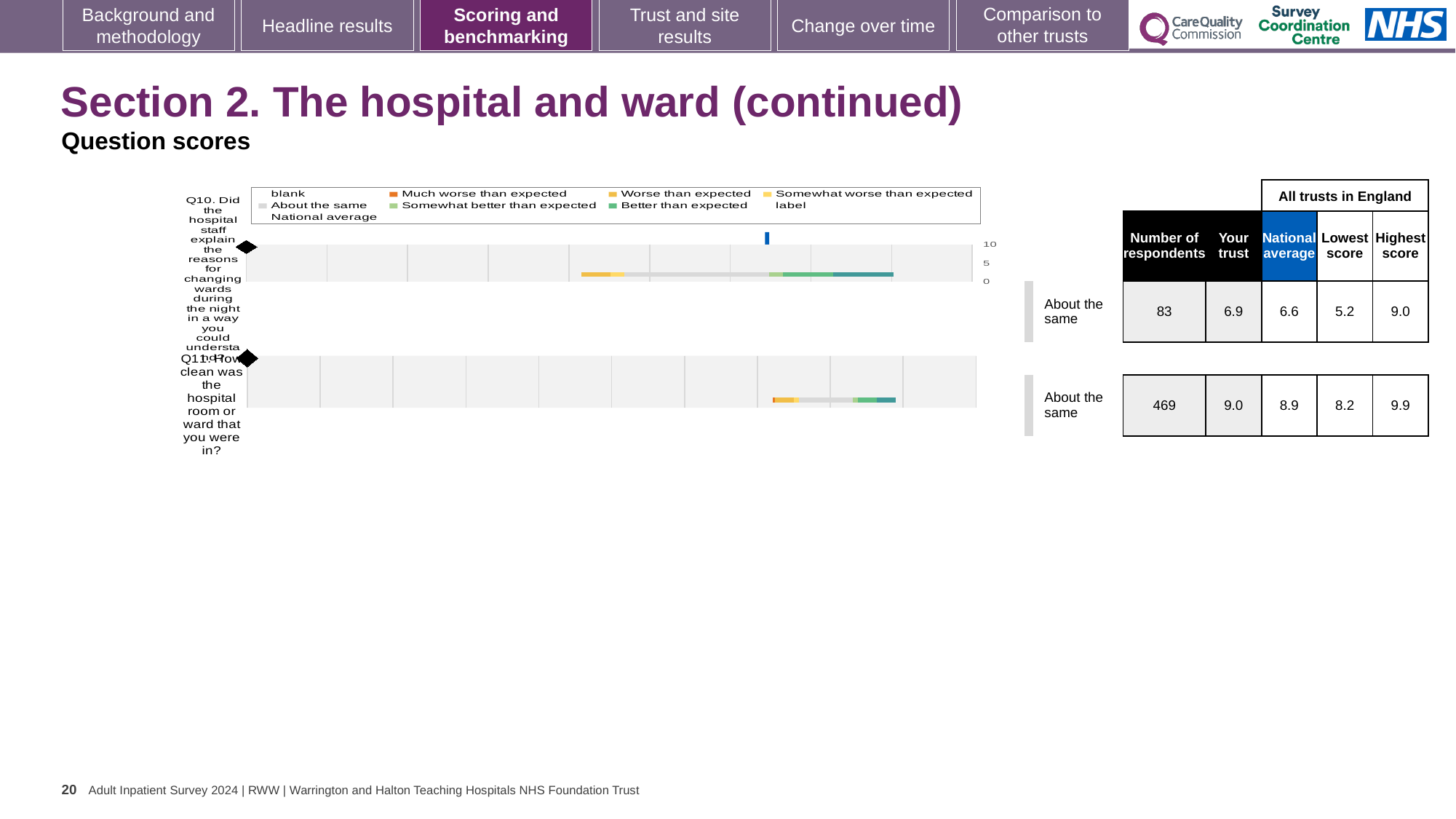
What is the highest score among all trusts in England for Q10? 9.0 What is the trust's score for Q10 (Did the hospital staff explain the reasons for changing wards during the night in a way you could understand?)? 6.9 What is the national average score for Q10? 6.6 What benchmarking category is shown for both Q10 and Q11? About the same Which question has the higher trust score, Q10 or Q11? Q11 How many respondents answered Q11? 469 What kind of chart is used to show the question scores on this slide? bar chart What is the difference between the trust's score and the national average for Q10? 0.3 How many survey questions are plotted in the chart? 2 What is the national average score for Q11? 8.9 What is the trust's score for Q11 (How clean was the hospital room or ward that you were in?)? 9.0 Is the trust's score for Q10 greater or less than 5? greater